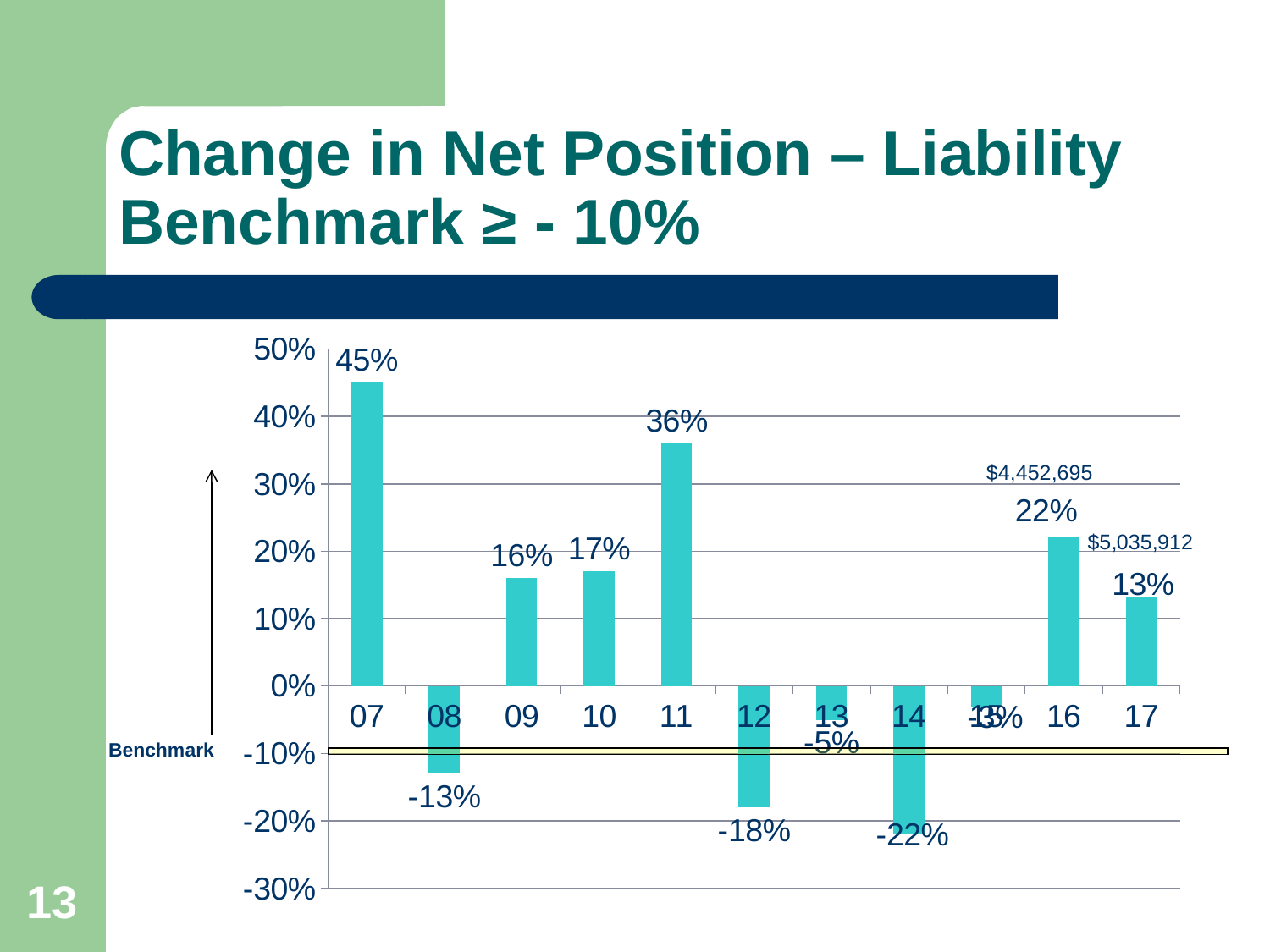
What is the change in net position for 11? 36% At what value is the benchmark line drawn on the chart? -10% How many years are shown on the x axis? 11 Which year has the highest change in net position? 07 Which is larger, the value for 09 or the value for 10? 10 What is the difference between the values for 07 and 11? 9 percentage points What is the change in net position for 14? -22% What is the change in net position for 16? 22% What kind of chart is shown on the slide? bar chart Is the value for 11 greater or less than 30%? greater Which year has the lowest change in net position? 14 What is the change in net position for 07? 45%